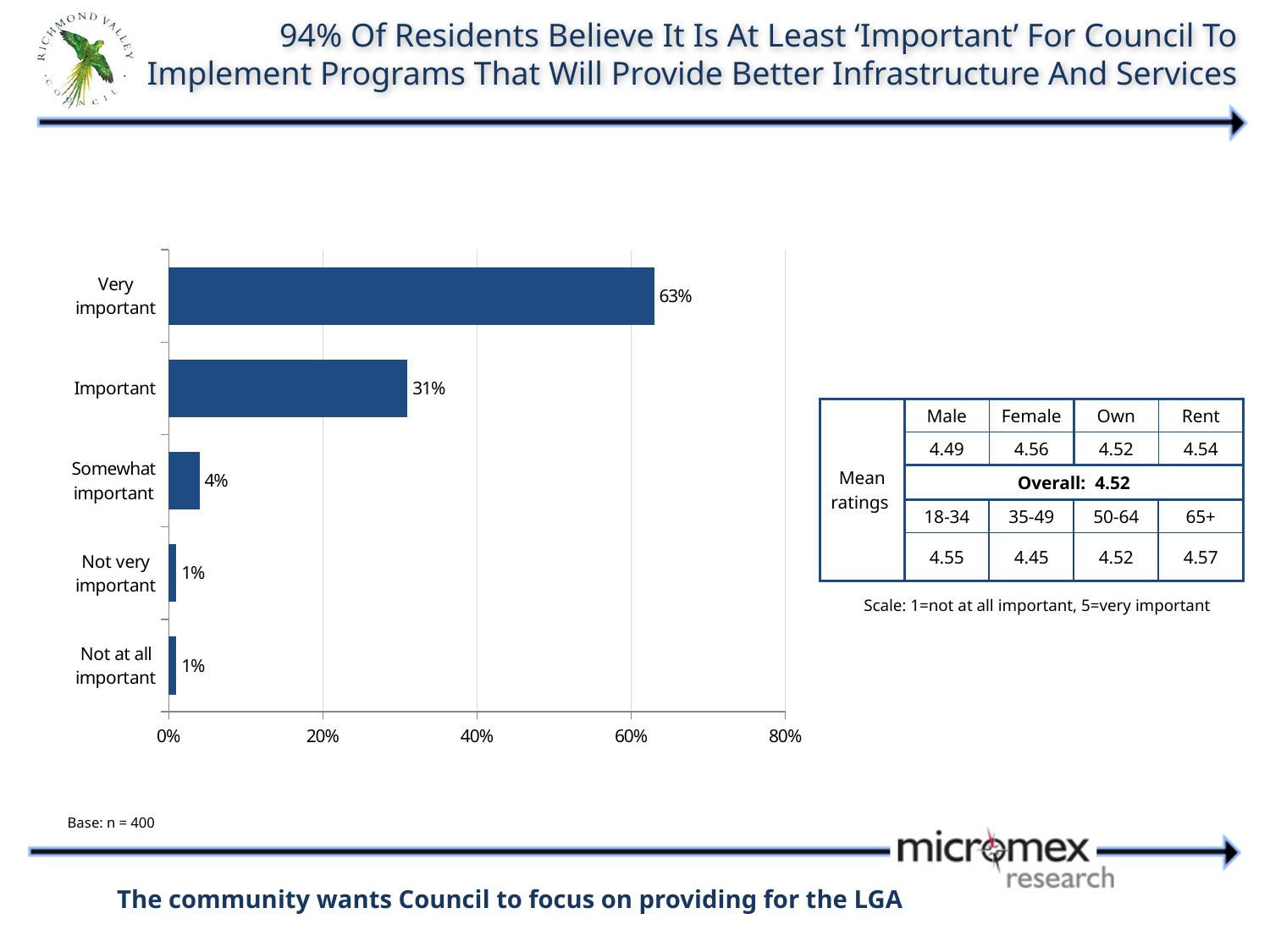
What kind of chart is shown on the slide? Bar chart What is the maximum value shown on the x axis of the chart? 80% What is the base sample size noted below the chart? n = 400 What is the difference in percentage points between 'Very important' and 'Important'? 32 What percentage of residents rated it 'Very important'? 63% Which category has the highest percentage? Very important Is the value for 'Very important' greater or less than 60%? greater Which is larger, the value for 'Important' or the value for 'Somewhat important'? Important What is the combined percentage of 'Very important' and 'Important'? 94% What percentage of residents rated it 'Somewhat important'? 4% What percentage of residents rated it 'Important'? 31% How many categories are shown in the bar chart? 5